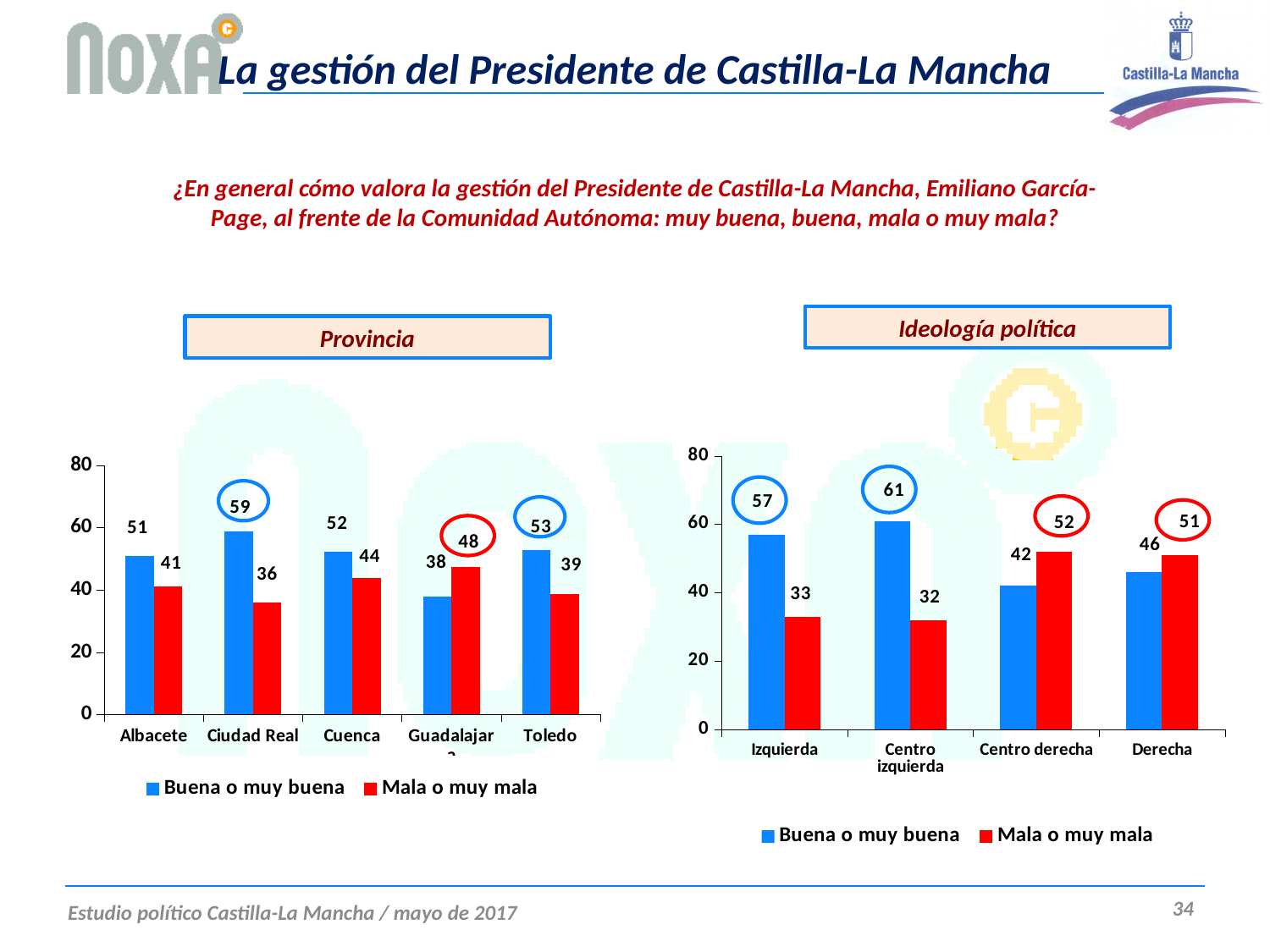
What type of chart is the Provincia chart? Bar chart In the Provincia chart, which province has the lowest 'Mala o muy mala' value? Ciudad Real In the Ideología política chart, which is larger for Izquierda: 'Buena o muy buena' or 'Mala o muy mala'? Buena o muy buena In the Ideología política chart, what is the value of 'Mala o muy mala' for Derecha? 51 In the Provincia chart, what is the value of 'Buena o muy buena' for Ciudad Real? 59 In the Provincia chart, how many provinces are shown on the x axis? 5 In the Provincia chart, what is the difference between 'Buena o muy buena' and 'Mala o muy mala' for Toledo? 14 In the Ideología política chart, which group has the lowest 'Buena o muy buena' value? Centro derecha In the Ideología política chart, how many series does the legend list? 2 In the Provincia chart, what is the value of 'Mala o muy mala' for Guadalajara? 48 In the Ideología política chart, what is the value of 'Buena o muy buena' for Centro izquierda? 61 In the Provincia chart, which province has the highest 'Buena o muy buena' value? Ciudad Real